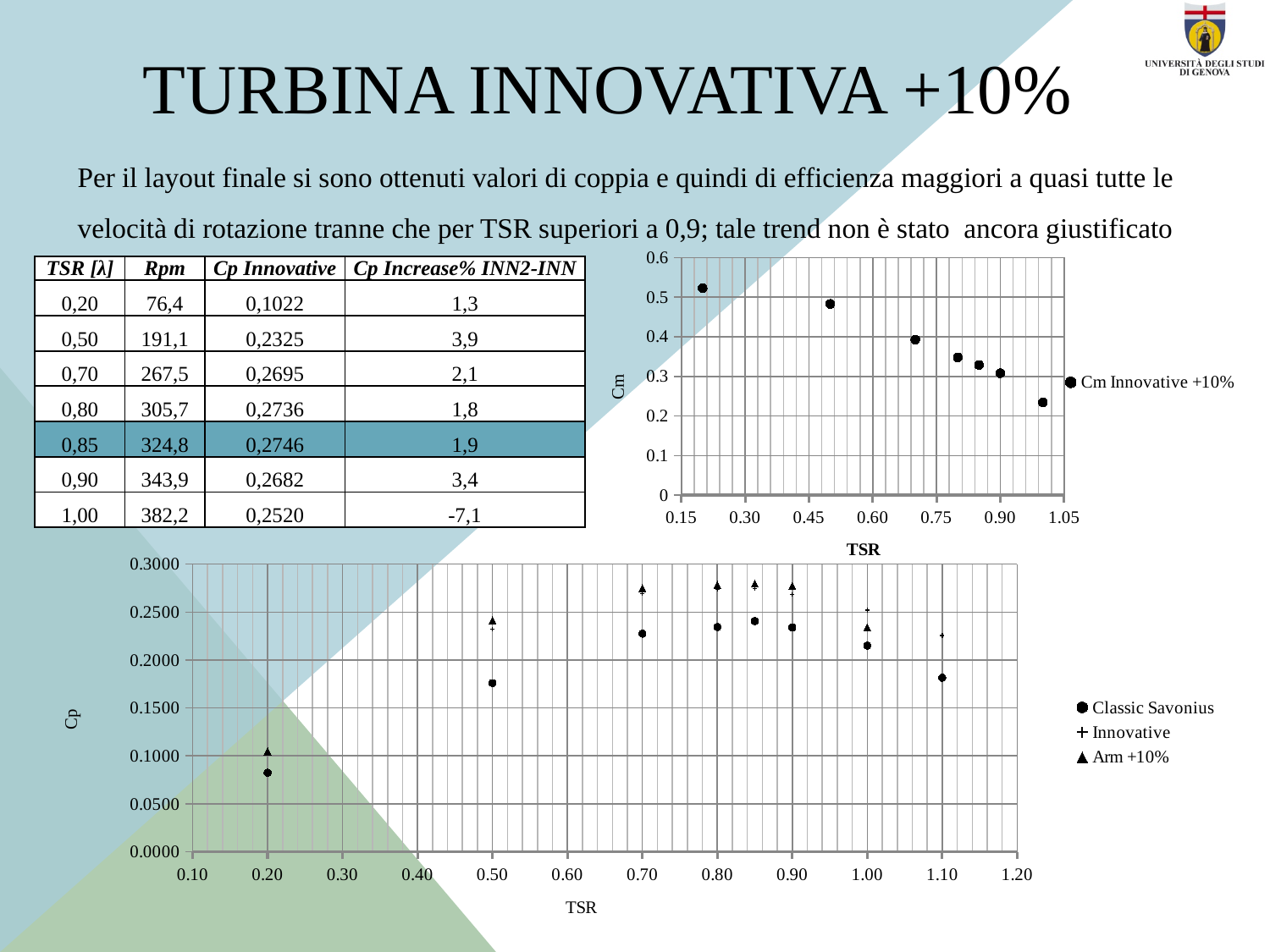
What kind of chart is the top-right chart titled 'Cm Innovative +10%'? scatter chart In the top-right chart (Cm vs TSR), do the Cm values rise or fall as TSR increases? fall In the top-right chart (Cm vs TSR), is the Cm value at TSR 1.00 greater or less than 0.3? less In the bottom chart (Cp vs TSR), at TSR 0.50, which series has the higher Cp: Classic Savonius or Arm +10%? Arm +10% What are the three series named in the legend of the bottom chart (Cp vs TSR)? Classic Savonius, Innovative, Arm +10% In the top-right chart (Cm vs TSR), is the Cm value at TSR 0.50 greater or less than 0.4? greater In the bottom chart (Cp vs TSR), is the Classic Savonius value at TSR 0.20 greater or less than 0.1000? less What is the label of the vertical axis of the top-right chart? Cm In the top-right chart (Cm vs TSR), how many data points are plotted? 7 In the top-right chart (Cm vs TSR), at which TSR value is Cm highest? 0.20 How many series does the legend of the bottom chart (Cp vs TSR) list? 3